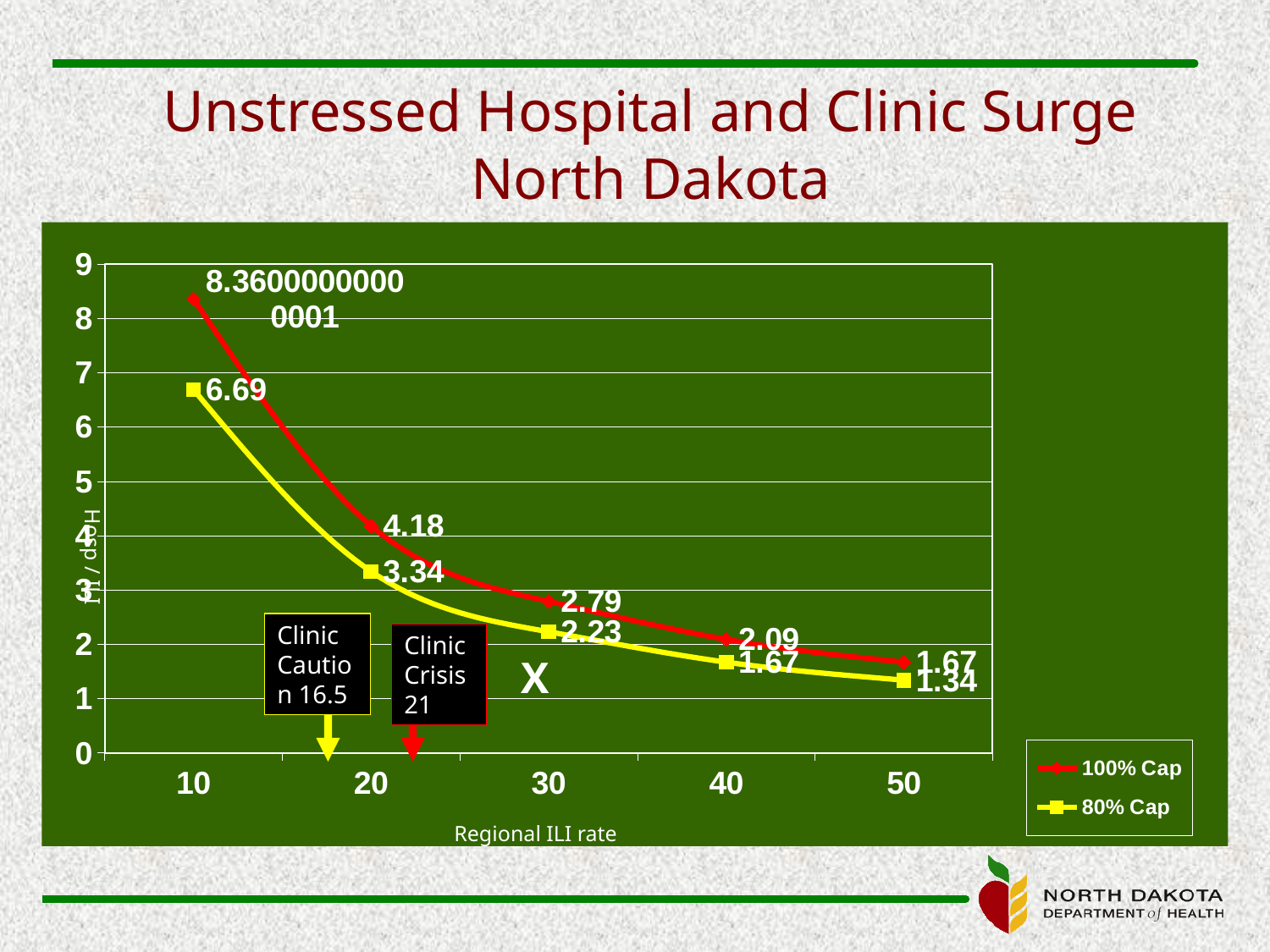
Do the values of the 100% Cap series rise or fall as the Regional ILI rate increases? fall At a Regional ILI rate of 20, what is the difference between the 100% Cap value and the 80% Cap value? 0.84 At a Regional ILI rate of 50, what is the difference between the 100% Cap value and the 80% Cap value? 0.33 What is the value of the 80% Cap series at a Regional ILI rate of 10? 6.69 At a Regional ILI rate of 30, which series has the larger value, 100% Cap or 80% Cap? 100% Cap How many Regional ILI rate points are plotted for each series? 5 What is the value of the 100% Cap series at a Regional ILI rate of 40? 2.09 What is the value of the 100% Cap series at a Regional ILI rate of 20? 4.18 What is the title of the x axis? Regional ILI rate How many series does the legend list? 2 What kind of chart is shown on the slide? line chart What is the value of the 80% Cap series at a Regional ILI rate of 50? 1.34